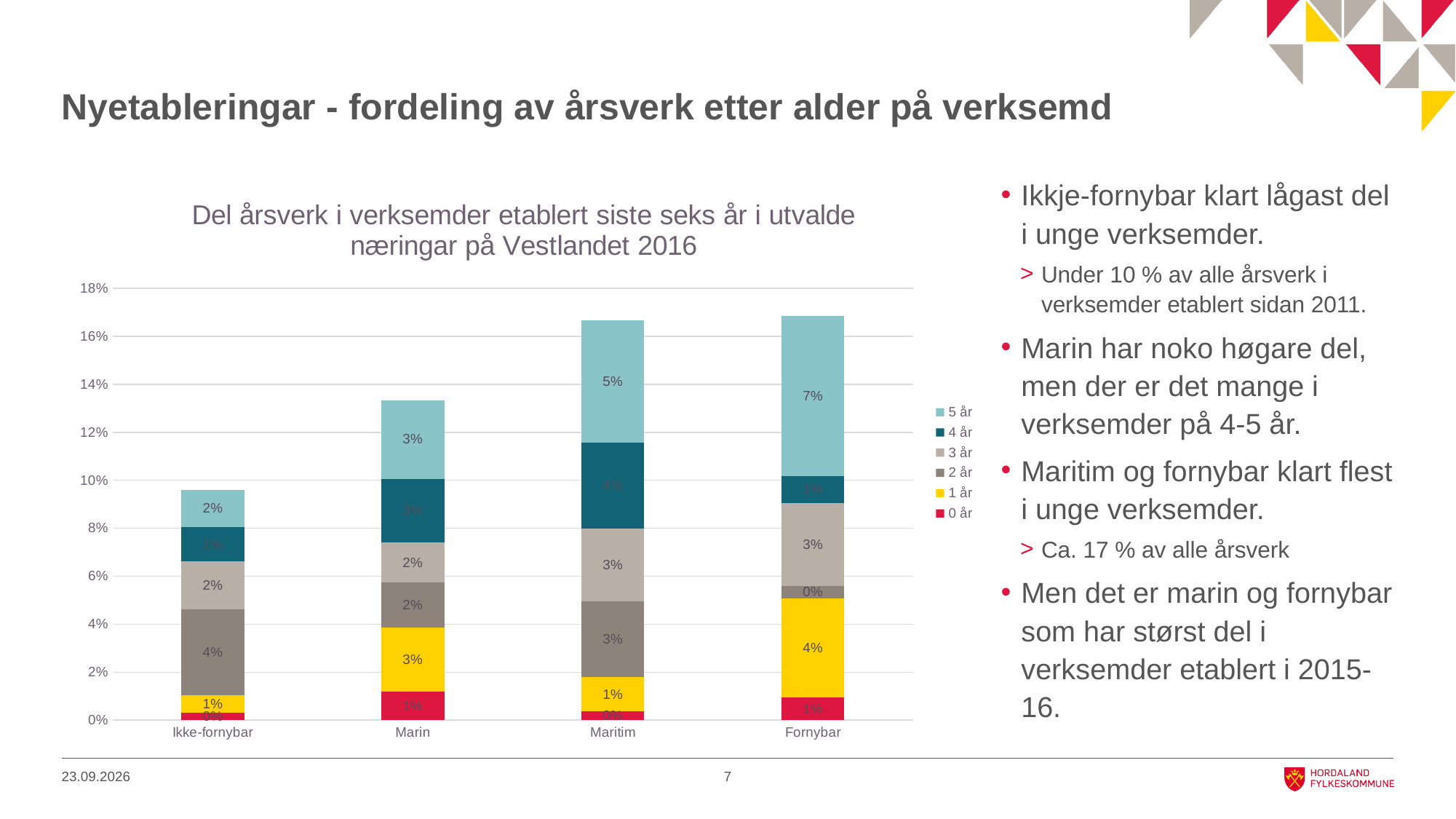
What kind of chart is shown on the slide? Stacked bar chart How many series does the chart legend list? 6 What is the title of the chart? Del årsverk i verksemder etablert siste seks år i utvalde næringar på Vestlandet 2016 How many categories are shown on the x axis of the chart? 4 What is the value of the 5 år segment for Fornybar? 7% Is the total bar for Marin greater or less than 12%? greater What is the value of the 2 år segment for Ikke-fornybar? 4% Which category has the lowest total bar? Ikke-fornybar What is the value of the 5 år segment for Maritim? 5% Is the total bar for Ikke-fornybar greater or less than 10%? less What is the value of the 1 år segment for Marin? 3% Which is larger, the 5 år segment for Fornybar or the 5 år segment for Maritim? Fornybar